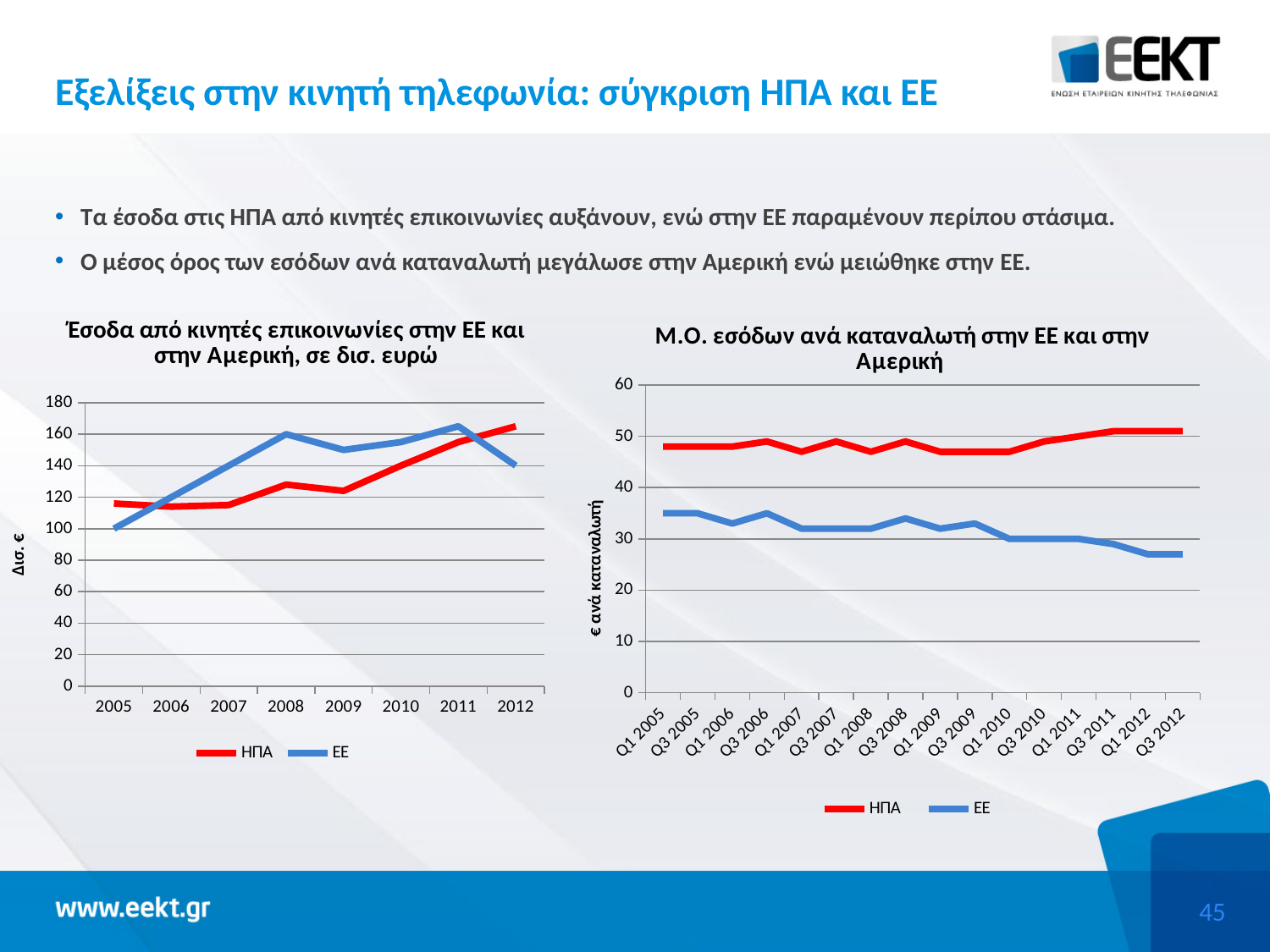
On the left chart (Έσοδα από κινητές επικοινωνίες), is the value for ΕΕ in 2005 greater or less than 120? less On the left chart (Έσοδα από κινητές επικοινωνίες), what is the label of the y axis? Δισ. € On the left chart (Έσοδα από κινητές επικοινωνίες), which series has the larger value in 2012, ΗΠΑ or ΕΕ? ΗΠΑ On the left chart (Έσοδα από κινητές επικοινωνίες), how many years are shown on the x axis? 8 On the right chart (Μ.Ο. εσόδων ανά καταναλωτή), does the ΕΕ series rise or fall from Q1 2005 to Q3 2012? fall On the right chart (Μ.Ο. εσόδων ανά καταναλωτή), is the value for ΗΠΑ in Q3 2012 greater or less than 40? greater On the left chart (Έσοδα από κινητές επικοινωνίες), is the value for ΗΠΑ in 2012 greater or less than 140? greater On the left chart (Έσοδα από κινητές επικοινωνίες), how many series does the legend list? 2 On the right chart (Μ.Ο. εσόδων ανά καταναλωτή), how many quarters are labelled on the x axis? 16 On the right chart (Μ.Ο. εσόδων ανά καταναλωτή), how many series does the legend list? 2 On the left chart (Έσοδα από κινητές επικοινωνίες στην ΕΕ και στην Αμερική), what kind of chart is shown? line chart On the left chart (Έσοδα από κινητές επικοινωνίες), which series has the larger value in 2008, ΗΠΑ or ΕΕ? ΕΕ